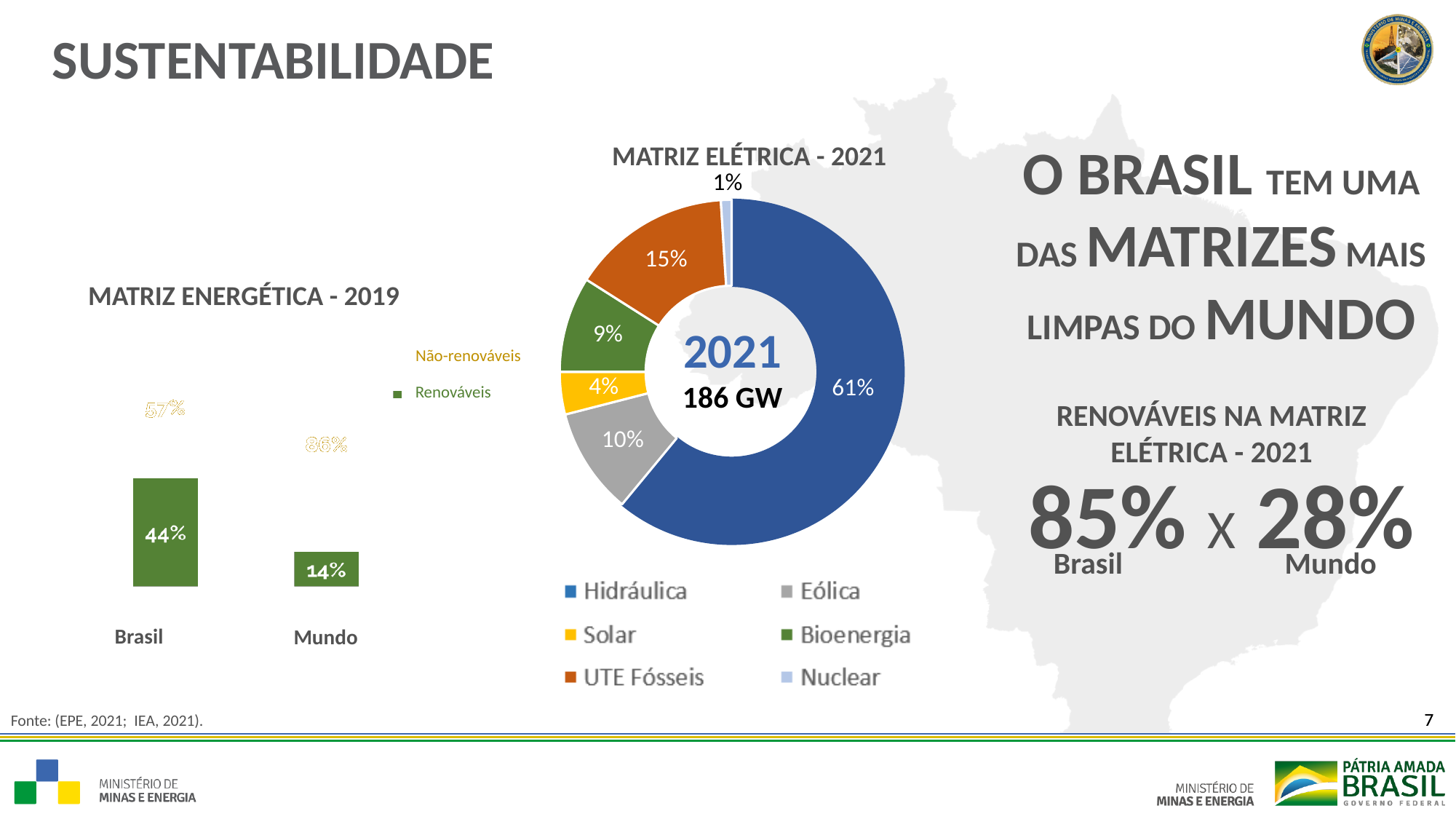
What total capacity is shown in the centre of the MATRIZ ELÉTRICA - 2021 chart? 186 GW In the MATRIZ ELÉTRICA - 2021 chart, what share does Solar have? 4% In the MATRIZ ELÉTRICA - 2021 chart, which source has the largest share? Hidráulica In the MATRIZ ELÉTRICA - 2021 chart, which is larger, Eólica or Solar? Eólica In the MATRIZ ELÉTRICA - 2021 chart, what is the difference between the Eólica and Bioenergia shares? 1% How many sources does the legend of the MATRIZ ELÉTRICA - 2021 chart list? 6 In the MATRIZ ENERGÉTICA - 2019 chart, what is the Renováveis value for Mundo? 14% In the MATRIZ ELÉTRICA - 2021 chart, what share does UTE Fósseis have? 15% In the MATRIZ ENERGÉTICA - 2019 chart, what is the Renováveis value for Brasil? 44% In the MATRIZ ELÉTRICA - 2021 chart, what share does Hidráulica have? 61% In the MATRIZ ELÉTRICA - 2021 chart, which source has the smallest share? Nuclear What kind of chart is MATRIZ ELÉTRICA - 2021? Donut (pie) chart